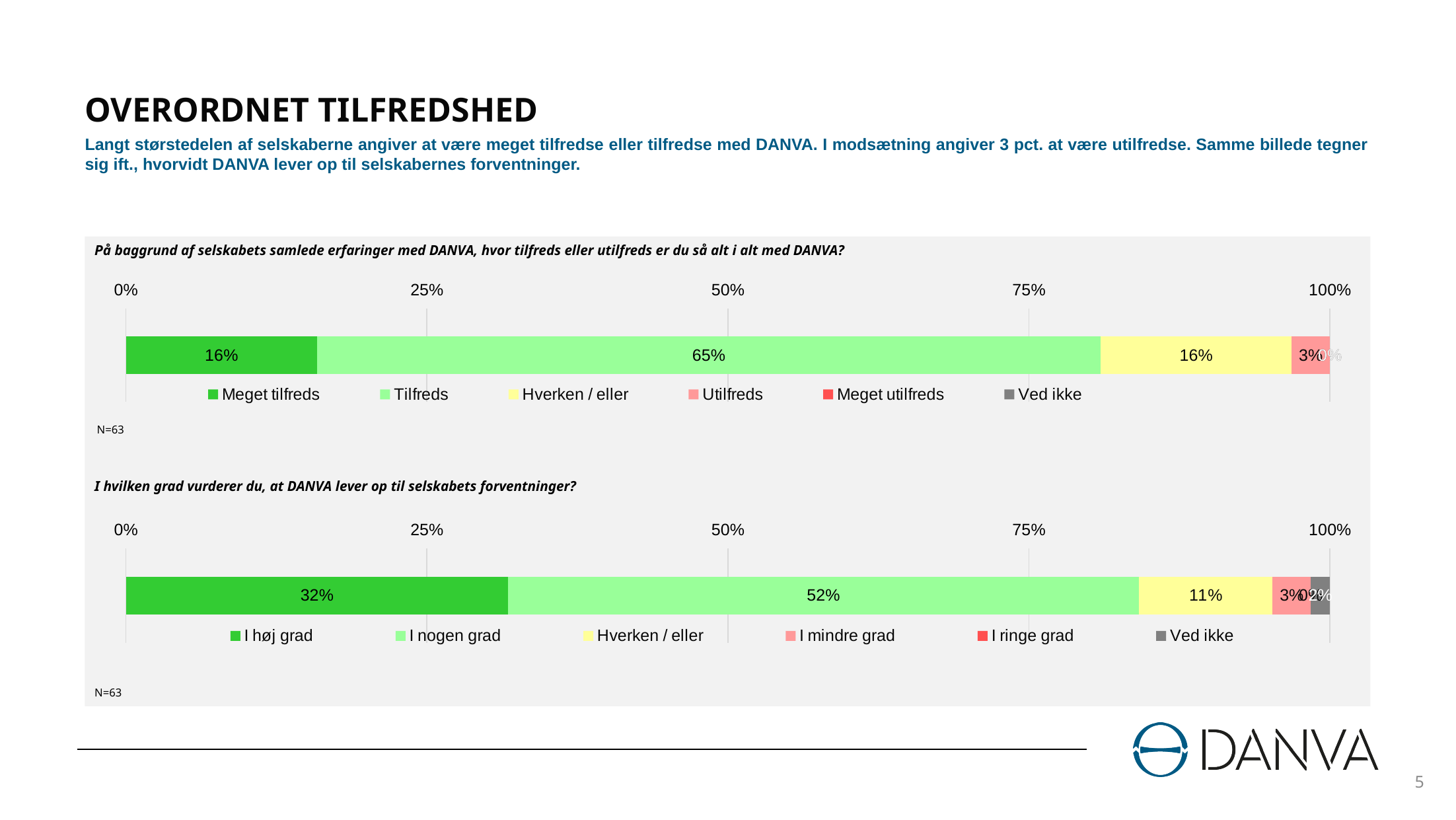
In the top chart (overall satisfaction with DANVA), what share of companies answered 'Meget tilfreds'? 16% In the bottom chart (whether DANVA lives up to expectations), which is larger: 'I høj grad' or 'Hverken / eller'? I høj grad What kind of chart is used on this slide to show the survey responses? Stacked horizontal bar chart What is the sample size (N) shown under each chart on the slide? N=63 In the top chart (overall satisfaction with DANVA), what share of companies answered 'Tilfreds'? 65% In the top chart (overall satisfaction with DANVA), what share of companies answered 'Utilfreds'? 3% In the bottom chart (whether DANVA lives up to expectations), what is the difference between the 'I nogen grad' share and the 'I høj grad' share? 20% In the bottom chart (whether DANVA lives up to expectations), what share of companies answered 'I høj grad'? 32% In the top chart (overall satisfaction with DANVA), which response category has the largest share? Tilfreds In the top chart (overall satisfaction with DANVA), how many entries does the legend list? 6 In the bottom chart (whether DANVA lives up to expectations), what share of companies answered 'Hverken / eller'? 11% In the bottom chart (whether DANVA lives up to expectations), what share of companies answered 'I nogen grad'? 52%